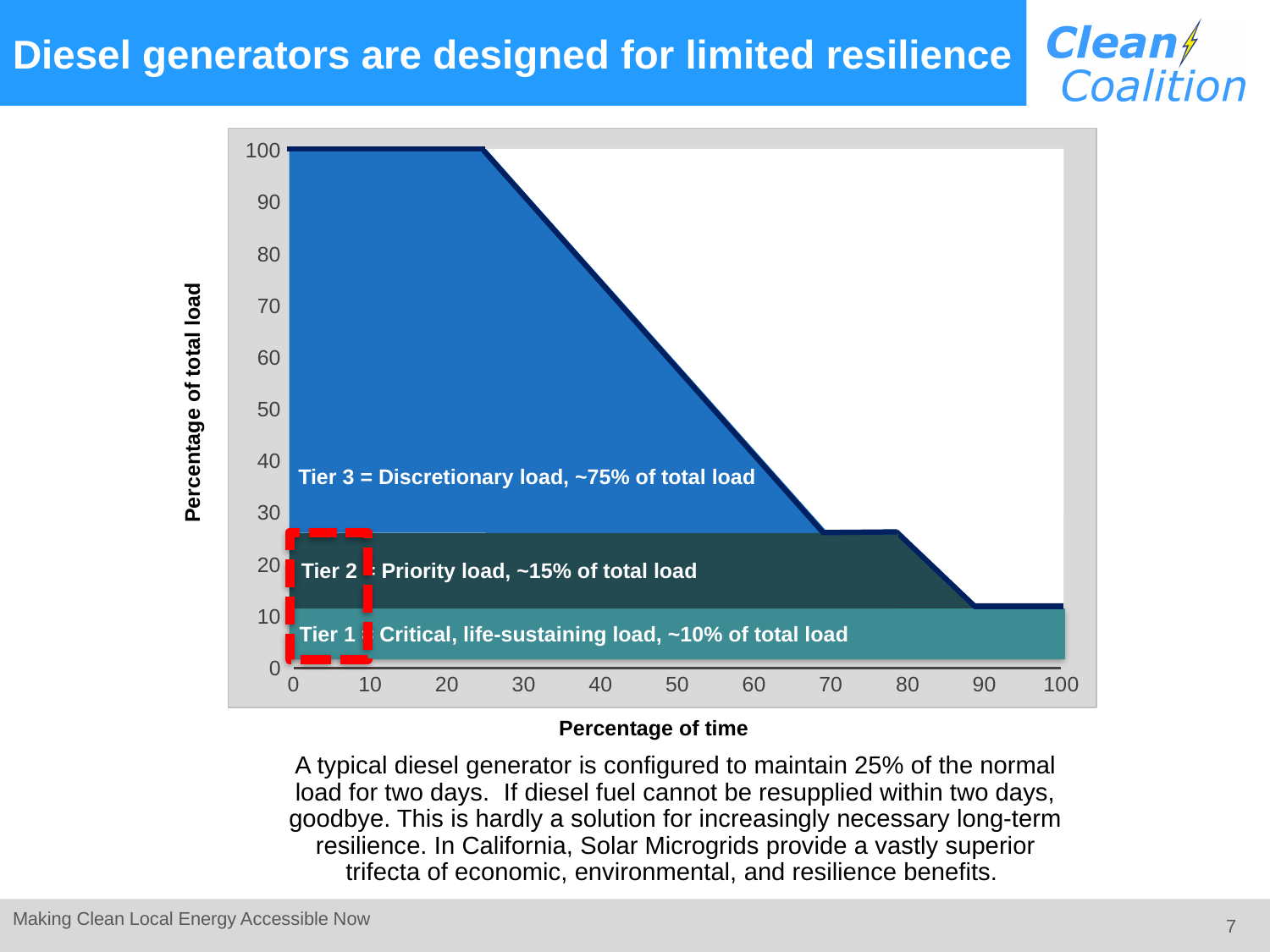
How many load tiers are labelled on the chart? 3 Is the percentage of total load at 10% of time greater or less than 90? greater Do the plotted values rise or fall as the percentage of time increases along the x axis? fall Is the percentage of total load at 100% of time greater or less than 20? less Is the percentage of total load at 60% of time greater or less than 50? less What is the label of the x axis of the chart? Percentage of time According to the chart label, what share of total load is Tier 3 (Discretionary load)? ~75% of total load What is the label of the y axis of the chart? Percentage of total load What kind of chart is shown on the slide? area chart What is the percentage of total load at 0% of time? 100 What is the highest value shown on the y axis of the chart? 100